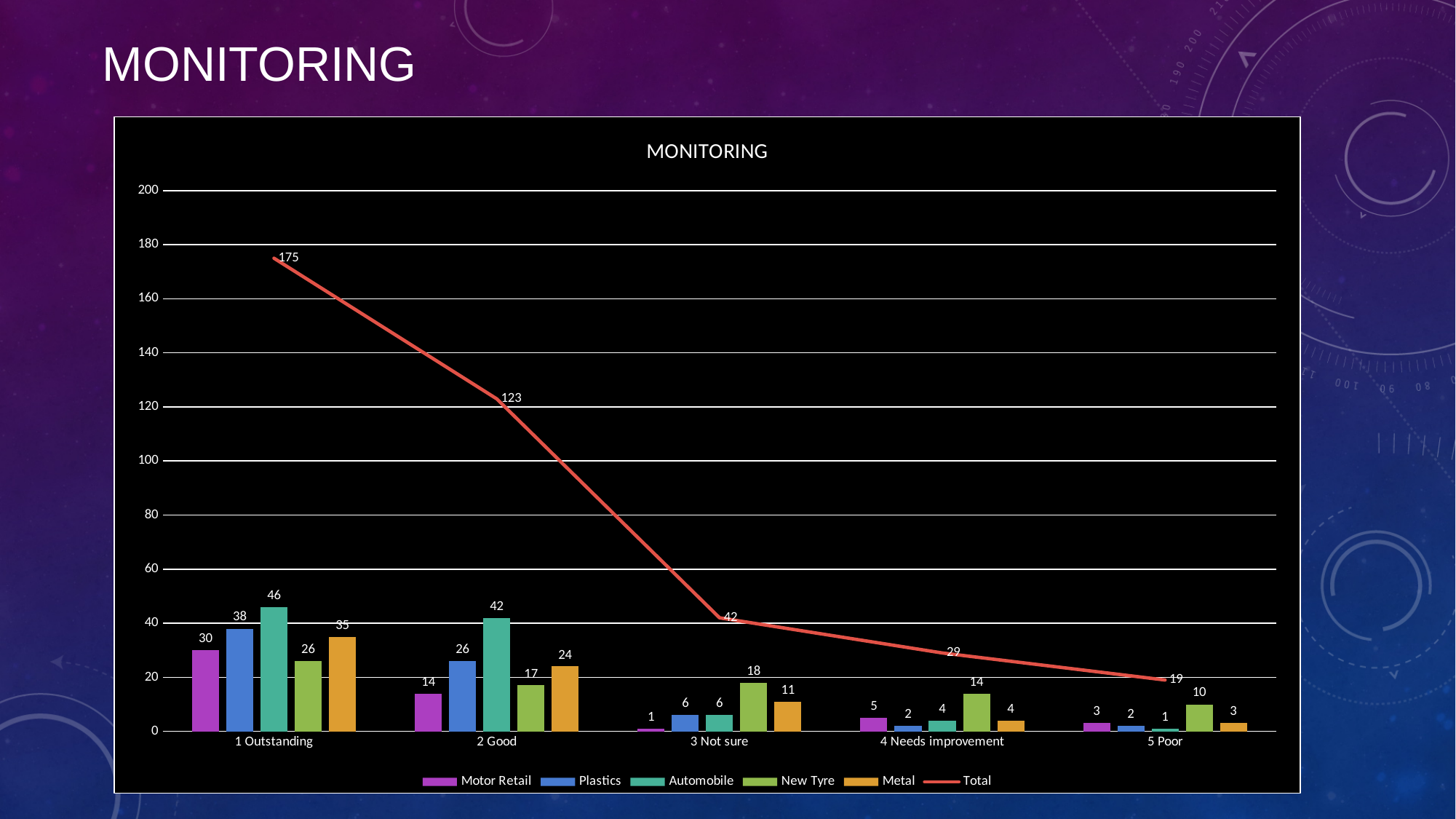
What is the value for Automobile in the 1 Outstanding category? 46 What is the Total value for the 3 Not sure category? 42 Which is larger in the 4 Needs improvement category, New Tyre or Metal? New Tyre Which series has the lowest value in the 5 Poor category? Automobile Does the Total line rise or fall from 1 Outstanding to 5 Poor? fall How many categories are shown on the x axis? 5 What is the title of the chart? MONITORING What is the difference between the Total for 1 Outstanding and the Total for 2 Good? 52 Is the Total value for 2 Good greater or less than 100? greater How many series does the legend list? 6 What is the value for Metal in the 2 Good category? 24 Which category has the highest Total value? 1 Outstanding